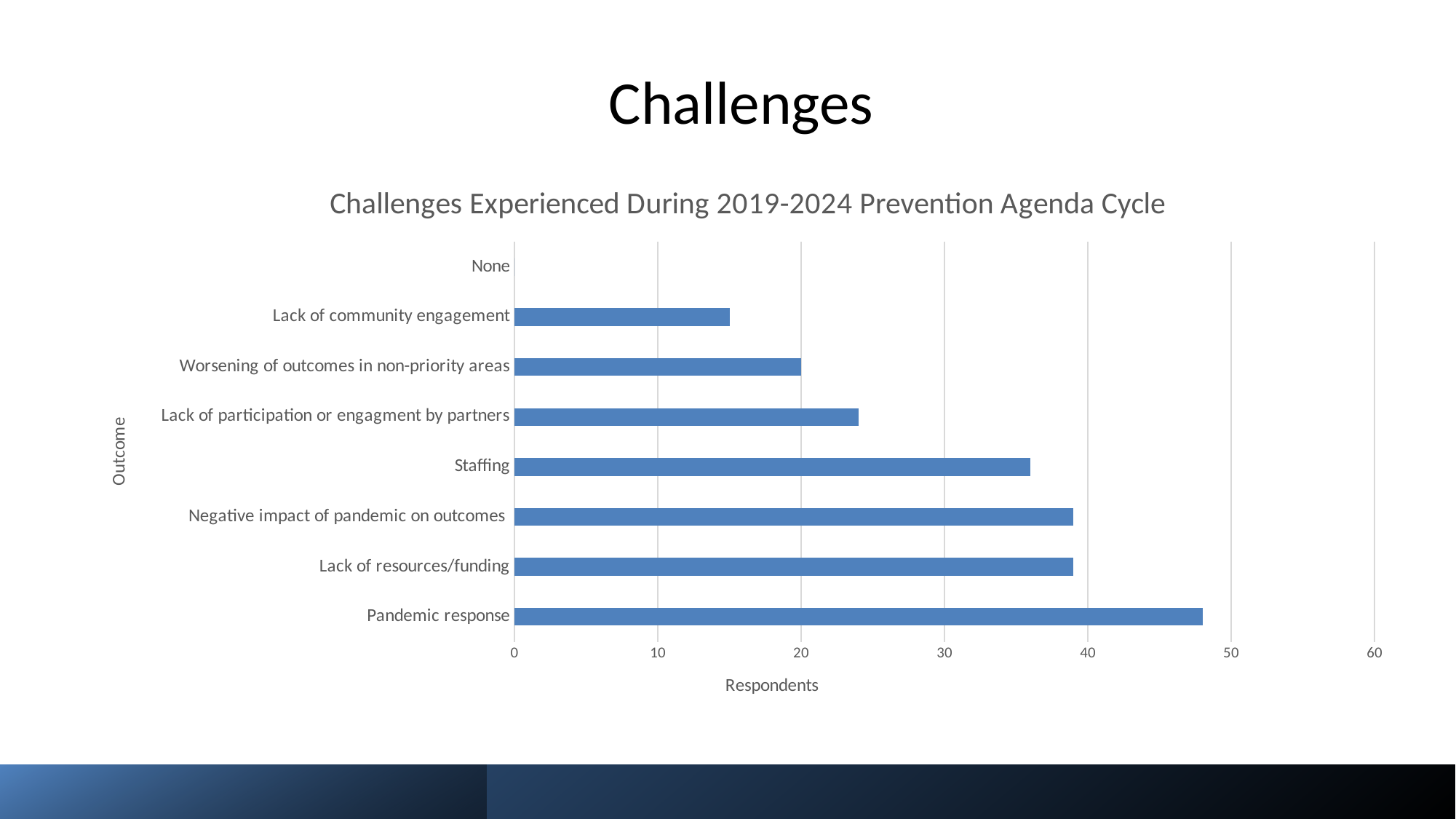
How many outcome categories are listed on the chart? 8 Which category has the lowest number of respondents? None What kind of chart is shown on the slide? Bar chart Which challenge has the highest number of respondents? Pandemic response Is the value for 'Lack of community engagement' greater or less than 20? less Is the value for 'Pandemic response' greater or less than 40? greater Is the value for 'Staffing' greater or less than 30? greater What is the label on the horizontal axis of the chart? Respondents Which has more respondents, 'Staffing' or 'Lack of participation or engagment by partners'? Staffing How many respondents reported 'Worsening of outcomes in non-priority areas'? 20 Which has more respondents, 'Lack of community engagement' or 'Lack of resources/funding'? Lack of resources/funding What is the title of the chart? Challenges Experienced During 2019-2024 Prevention Agenda Cycle